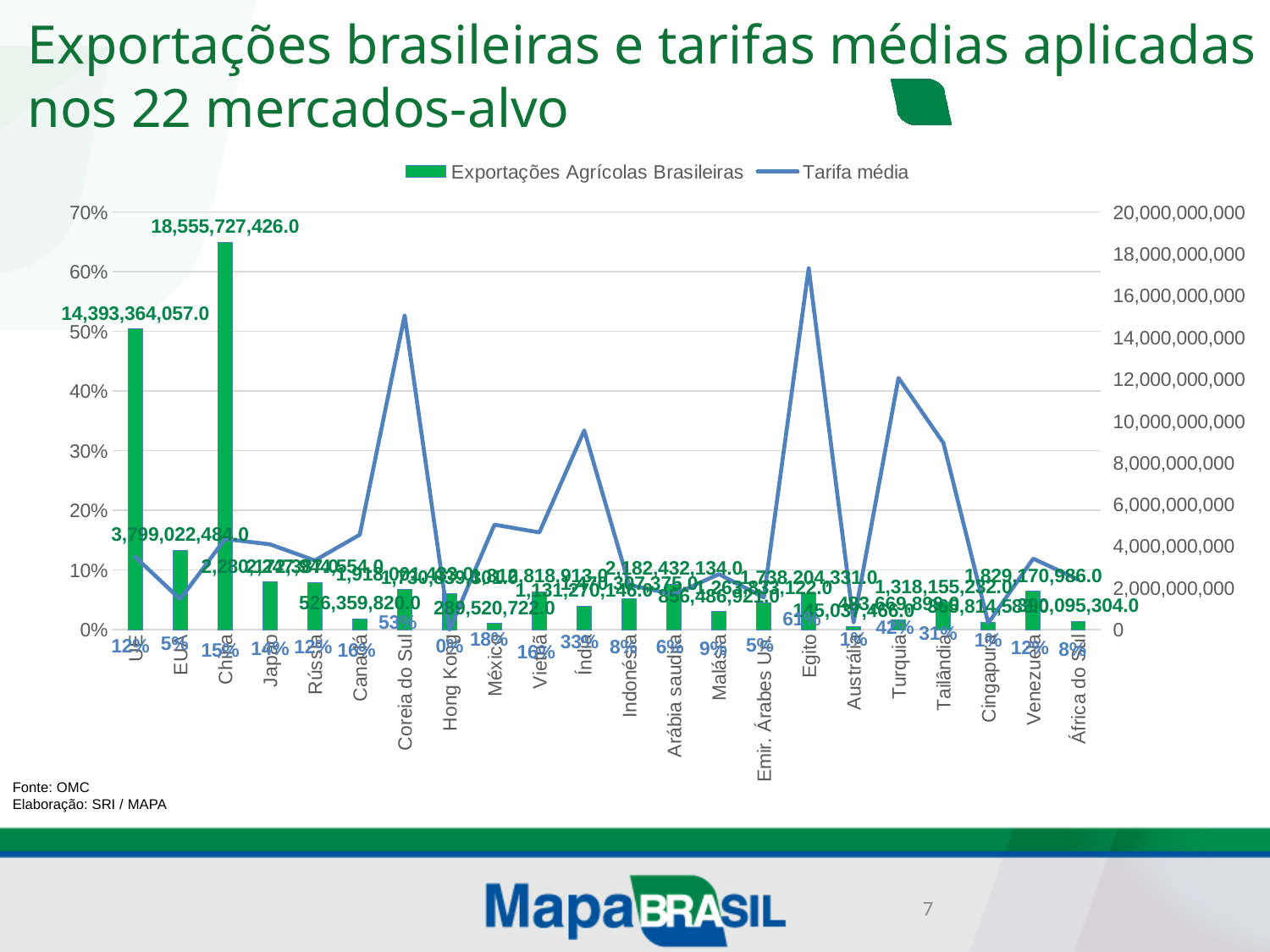
How many series does the legend list? 2 What is the Tarifa média for Coreia do Sul? 53% What kind of chart is shown on the slide? A combination bar and line chart Which market has the highest value for Exportações Agrícolas Brasileiras? China What is the value of Exportações Agrícolas Brasileiras for UE? 14,393,364,057.0 Which has a higher Tarifa média, Turquia or Índia? Turquia How many markets (categories) are shown on the x axis? 22 Which market has the highest Tarifa média? Egito Which market has the lowest Tarifa média? Hong Kong Is the Exportações Agrícolas Brasileiras value for Japão greater or less than 4,000,000,000? less What is the difference between the Exportações Agrícolas Brasileiras values for China and UE? 4,162,363,369.0 What is the value of Exportações Agrícolas Brasileiras for China? 18,555,727,426.0